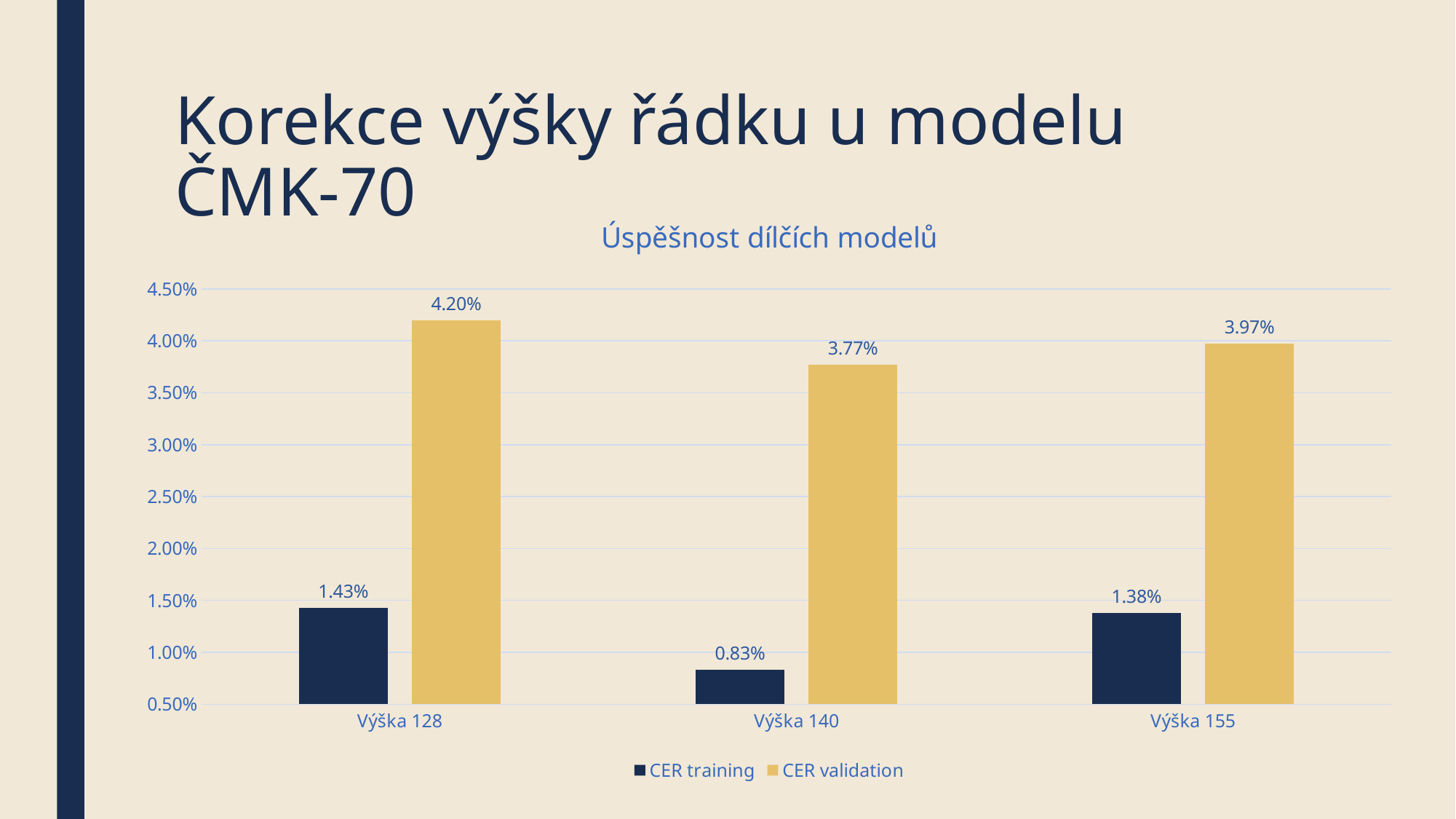
How many series does the legend list? 2 What is the CER validation value for Výška 155? 3.97% How many categories are shown on the x axis? 3 Which category has the lowest CER training value? Výška 140 What kind of chart is shown on the slide? Bar chart What is the title of the chart? Úspěšnost dílčích modelů What is the CER training value for Výška 128? 1.43% What is the CER validation value for Výška 140? 3.77% Is the CER validation value for Výška 140 greater or less than 3.50%? greater What is the difference between the CER validation and CER training values for Výška 128? 2.77% Which is larger: the CER training value for Výška 128 or for Výška 155? Výška 128 Which category has the highest CER validation value? Výška 128